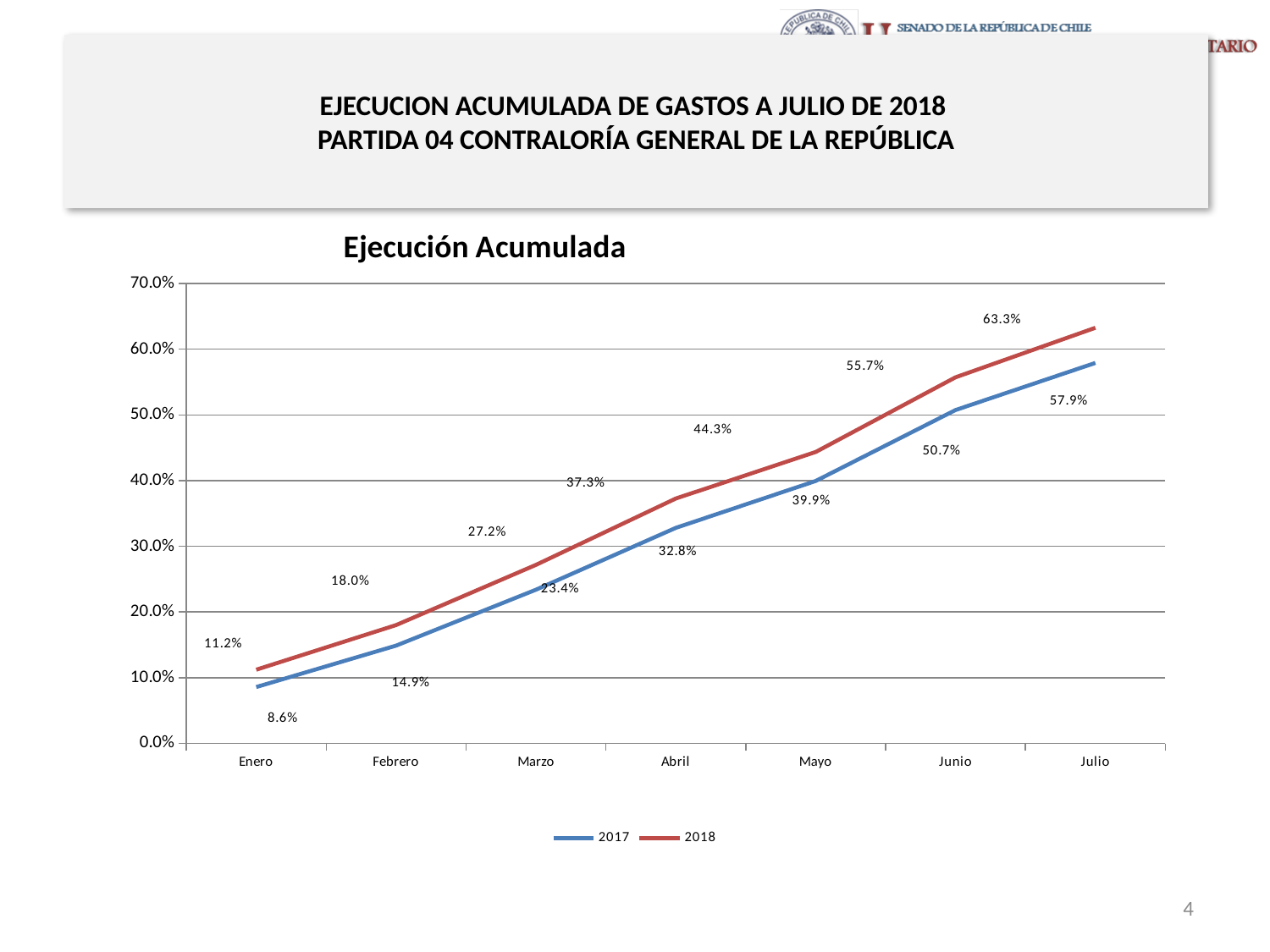
How many series does the legend list? 2 What type of chart is shown under the title "Ejecución Acumulada"? line chart In which month is the 2018 series at its lowest? Enero Which series has the larger value in Mayo, 2017 or 2018? 2018 What is the value for 2018 in Julio? 63.3% What is the value for 2017 in Abril? 32.8% Do the values for 2017 rise or fall from Enero to Julio? rise What is the value for 2018 in Marzo? 27.2% In which month is the 2017 series at its highest? Julio How many months are shown on the x axis? 7 What is the value for 2017 in Enero? 8.6% What is the difference between the 2018 and 2017 values in Julio? 5.4%